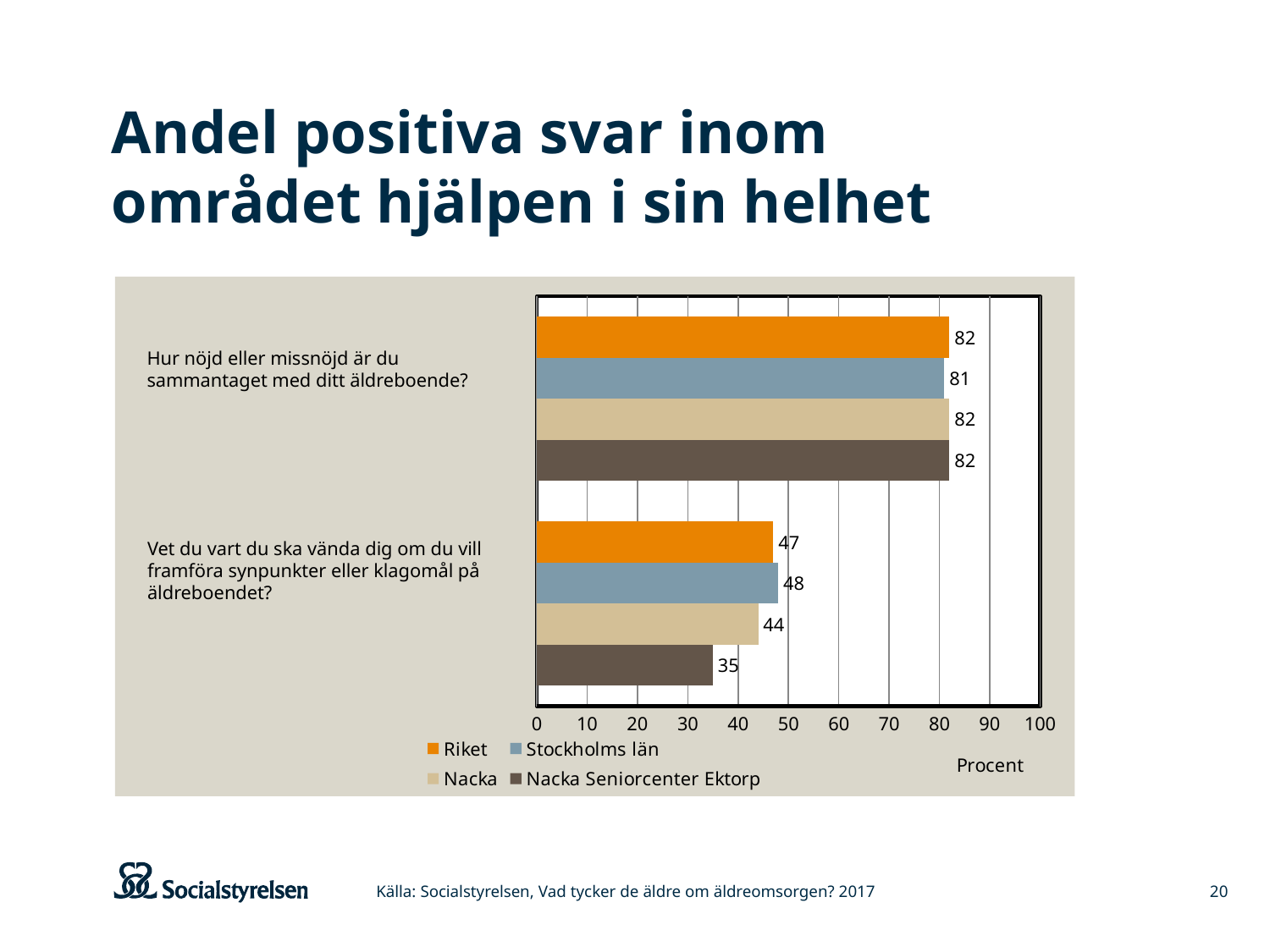
Which series has the lowest value on the question "Vet du vart du ska vända dig om du vill framföra synpunkter eller klagomål på äldreboendet?"? Nacka Seniorcenter Ektorp What is the value for Riket on the question "Vet du vart du ska vända dig om du vill framföra synpunkter eller klagomål på äldreboendet?"? 47 What is the value for Stockholms län on the question "Hur nöjd eller missnöjd är du sammantaget med ditt äldreboende?"? 81 How many questions (categories) are shown on the chart? 2 How many series does the legend list? 4 What kind of chart is shown on the slide? Bar chart What unit label is shown on the horizontal axis of the chart? Procent Which series has the highest value on the question "Vet du vart du ska vända dig om du vill framföra synpunkter eller klagomål på äldreboendet?"? Stockholms län What is the value for Nacka Seniorcenter Ektorp on the question "Vet du vart du ska vända dig om du vill framföra synpunkter eller klagomål på äldreboendet?"? 35 Which is larger on the question "Vet du vart du ska vända dig om du vill framföra synpunkter eller klagomål på äldreboendet?": the value for Nacka or the value for Nacka Seniorcenter Ektorp? Nacka What is the value for Nacka on the question "Vet du vart du ska vända dig om du vill framföra synpunkter eller klagomål på äldreboendet?"? 44 What is the difference between the Riket value and the Nacka Seniorcenter Ektorp value on the question "Vet du vart du ska vända dig om du vill framföra synpunkter eller klagomål på äldreboendet?"? 12